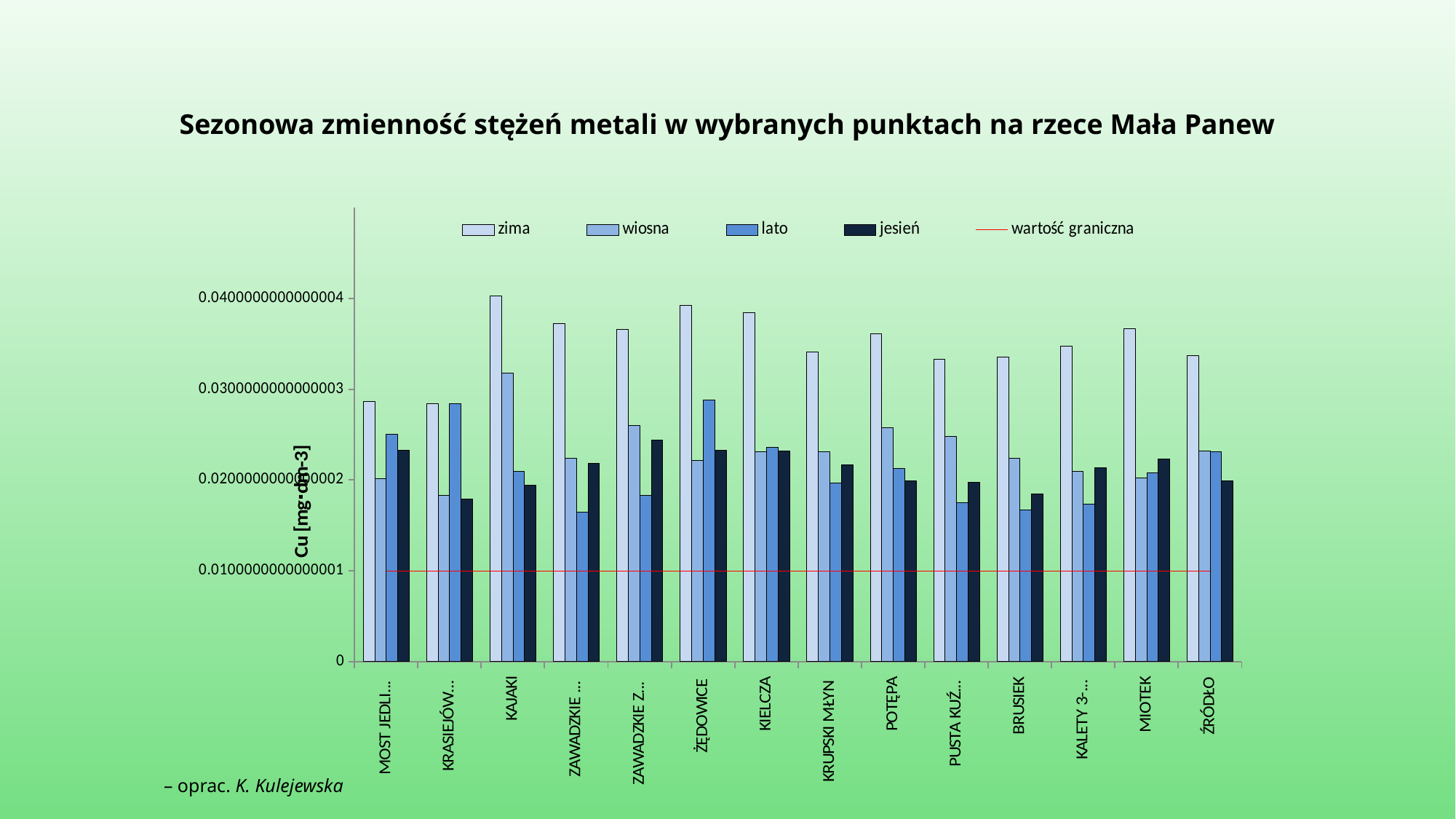
What is the label of the y axis? Cu [mg·dm-3] Is the lato value for BRUSIEK greater or less than 0.02? less At KRASIEJÓW, which is larger: the lato value or the wiosna value? lato How many entries does the legend list? 5 Is the zima value for KIELCZA greater or less than 0.03? greater Which season has the highest bar at POTĘPA? zima Is the wartość graniczna line greater or less than 0.02? less How many sampling points (categories) are shown on the x axis? 14 What kind of chart is shown on the slide? combination bar and line chart Which has the larger zima value: KAJAKI or MIOTEK? KAJAKI